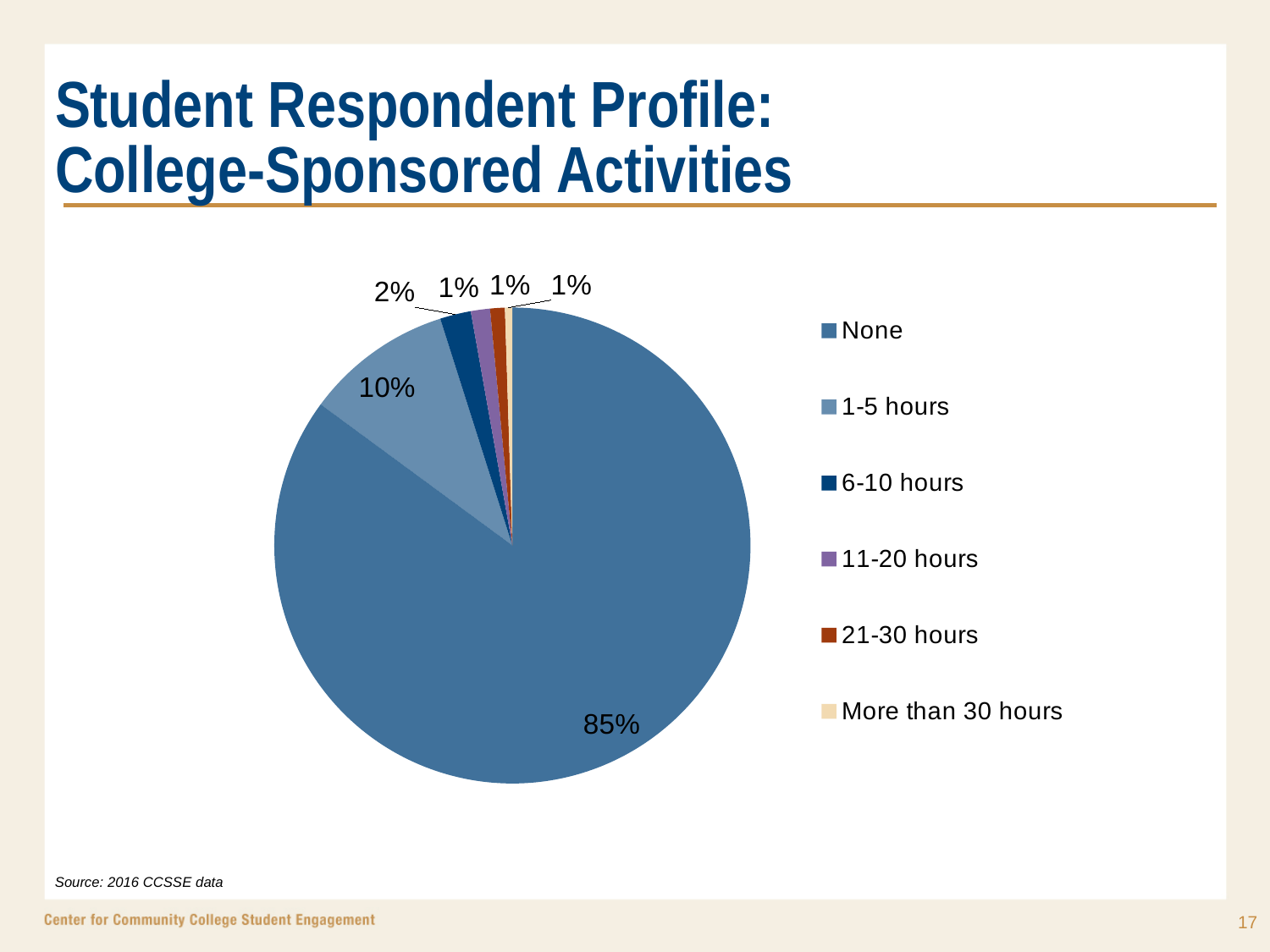
What kind of chart is shown on the slide? pie chart What share of the pie is labelled "None"? 85% Which is larger, the share for "1-5 hours" or the share for "6-10 hours"? 1-5 hours What data source is cited below the chart? 2016 CCSSE data How many categories does the legend list? 6 What is the difference between the "None" share and the "1-5 hours" share? 75% What share of the pie is labelled "6-10 hours"? 2% What is the combined share of "None" and "1-5 hours"? 95% What share of the pie is labelled "1-5 hours"? 10% What is the title of the slide containing the chart? Student Respondent Profile: College-Sponsored Activities Which category has the largest slice of the pie? None